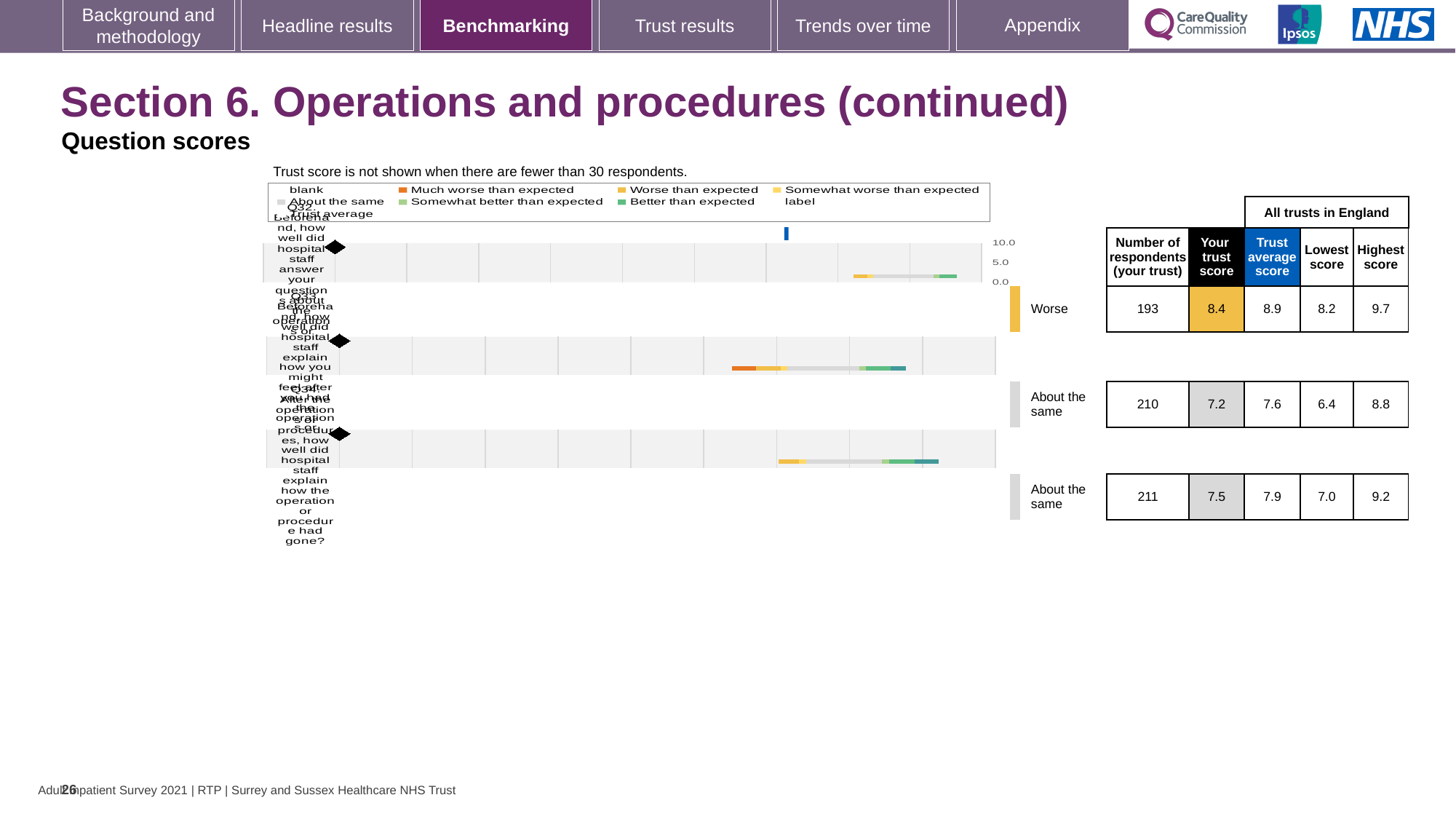
In the table, what is 'Your trust score' for the first row (rated 'Worse')? 8.4 In the table, what is the number of respondents for the first row (rated 'Worse')? 193 How many question rows are plotted in the chart? 3 What kind of chart is shown on the slide? bar chart In the table, what is the difference between the 'Trust average score' and 'Your trust score' in the first row? 0.5 Which row has the higher 'Your trust score': the first row (193 respondents) or the second row (210 respondents)? the first row How many of the three rows are rated 'About the same'? 2 In the table, what is the 'Lowest score' for the second row? 6.4 Which row has the highest number of respondents in the table? the third row (211) In the table, what is the 'Highest score' for the third row? 9.2 In the table, what is the difference between the 'Highest score' and 'Lowest score' in the first row? 1.5 In the table, what is the 'Trust average score' for the second row? 7.6